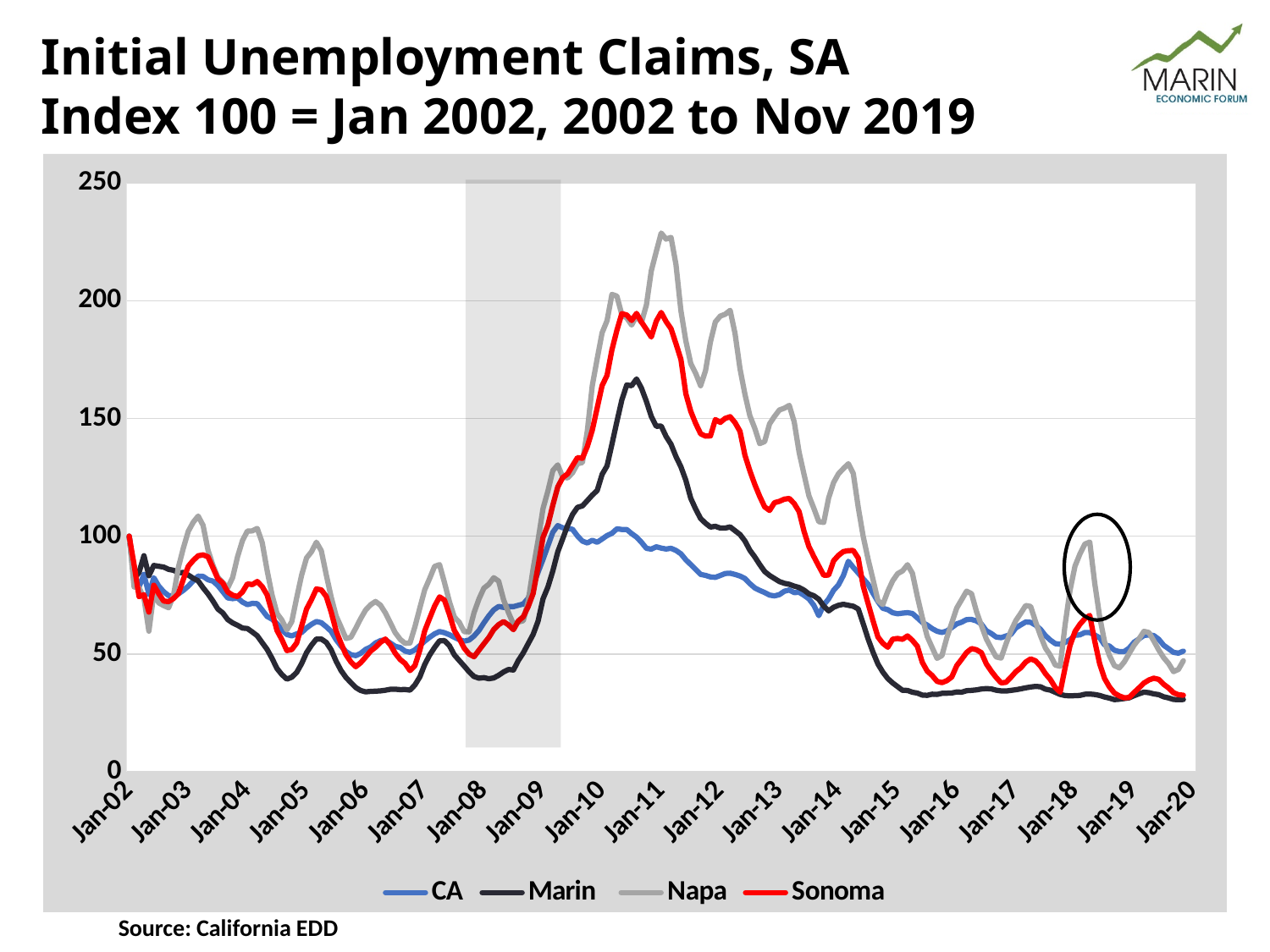
What kind of chart is shown on the slide? Line chart Is the peak value for Marin around Jan-11 greater or less than 150? greater Around Jan-11, which is larger, the value for Marin or the value for CA? Marin What colour is the Sonoma line? Red How many series does the legend list? 4 Is the peak value for Sonoma around Jan-11 greater or less than 200? less Is the peak value for Napa around Jan-11 greater or less than 200? greater Does the Marin series rise or fall between Jan-08 and Jan-10? Rise Which series reaches the highest peak on the chart? Napa Which series are listed in the legend? CA, Marin, Napa, Sonoma Does the Napa series rise or fall between Jan-11 and Jan-15? Fall